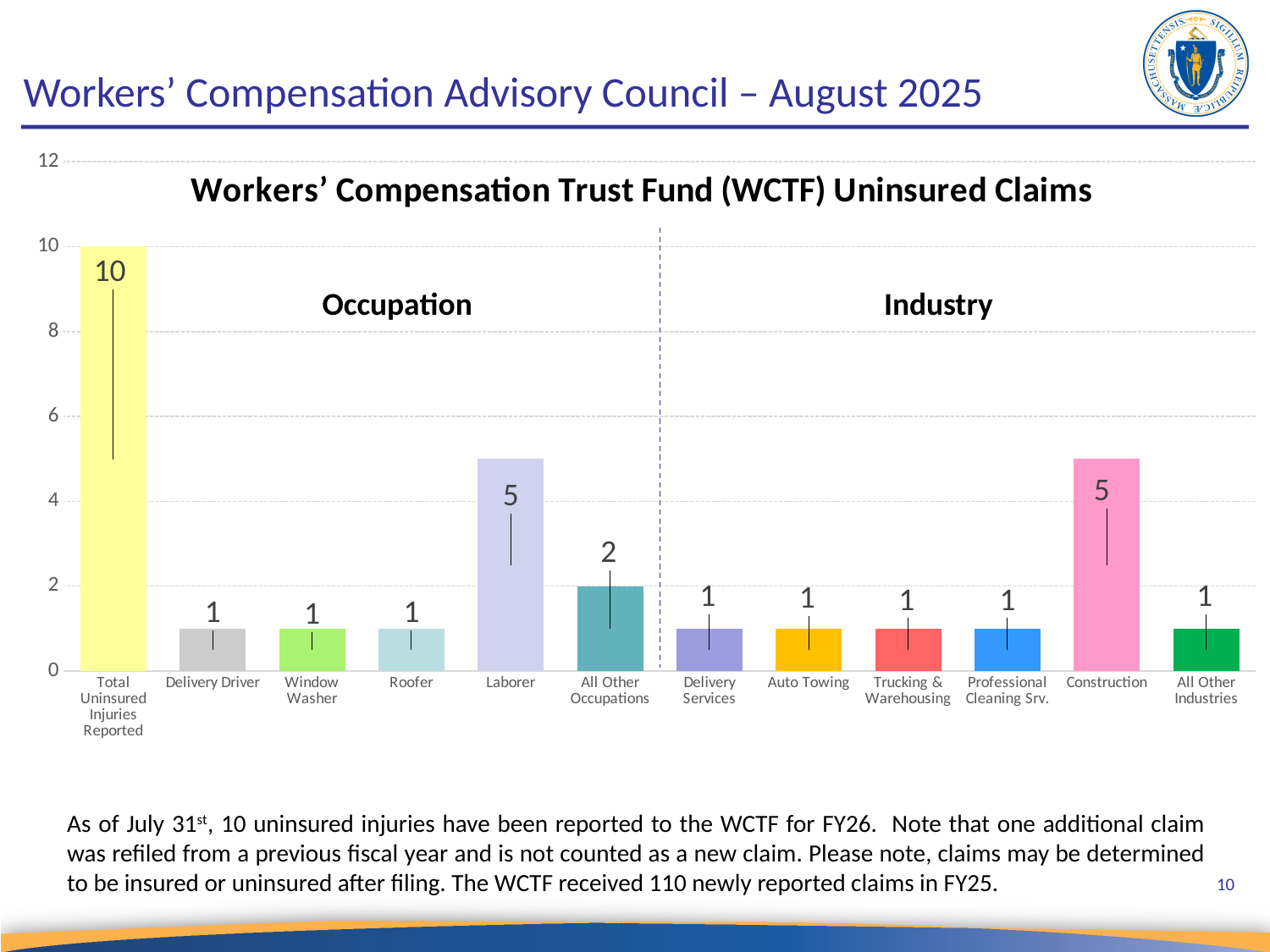
What is the difference between the values for Laborer and All Other Occupations? 3 What is the value for Auto Towing? 1 What is the value for All Other Occupations? 2 How many categories are shown on the x axis? 12 Which category has the highest value? Total Uninsured Injuries Reported Which occupation category (excluding the total) has the highest value? Laborer What is the value for Total Uninsured Injuries Reported? 10 What is the value for Laborer? 5 Which is larger, the value for Construction or the value for All Other Industries? Construction What kind of chart is this? Bar chart What is the value for Construction? 5 What is the title of the chart? Workers' Compensation Trust Fund (WCTF) Uninsured Claims